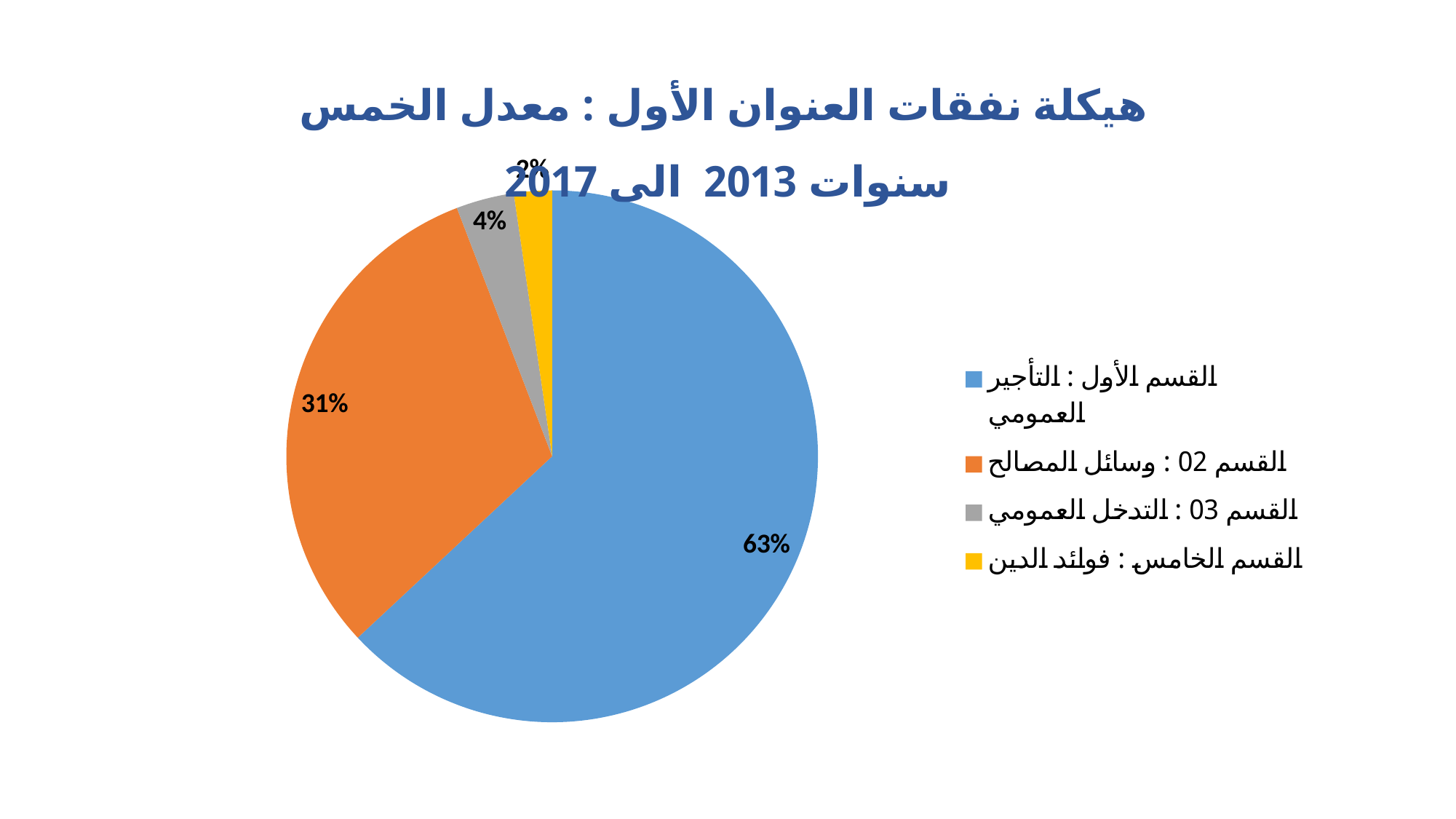
What is the title of the chart? هيكلة نفقات العنوان الأول : معدل الخمس سنوات 2013 الى 2017 What share of the pie does القسم الأول : التأجير العمومي represent? 63% Which category has the largest slice of the pie? القسم الأول : التأجير العمومي What share of the pie does القسم 03 : التدخل العمومي represent? 4% What is the difference in percentage points between القسم الأول : التأجير العمومي and القسم 02 : وسائل المصالح? 32 What share of the pie does القسم 02 : وسائل المصالح represent? 31% What kind of chart is shown on the slide? Pie chart Which category has the smallest slice of the pie? القسم الخامس : فوائد الدين How many categories does the pie chart show? 4 Which is larger, the share for القسم 03 : التدخل العمومي or the share for القسم الخامس : فوائد الدين? القسم 03 : التدخل العمومي What colour is the slice for القسم 02 : وسائل المصالح? Orange